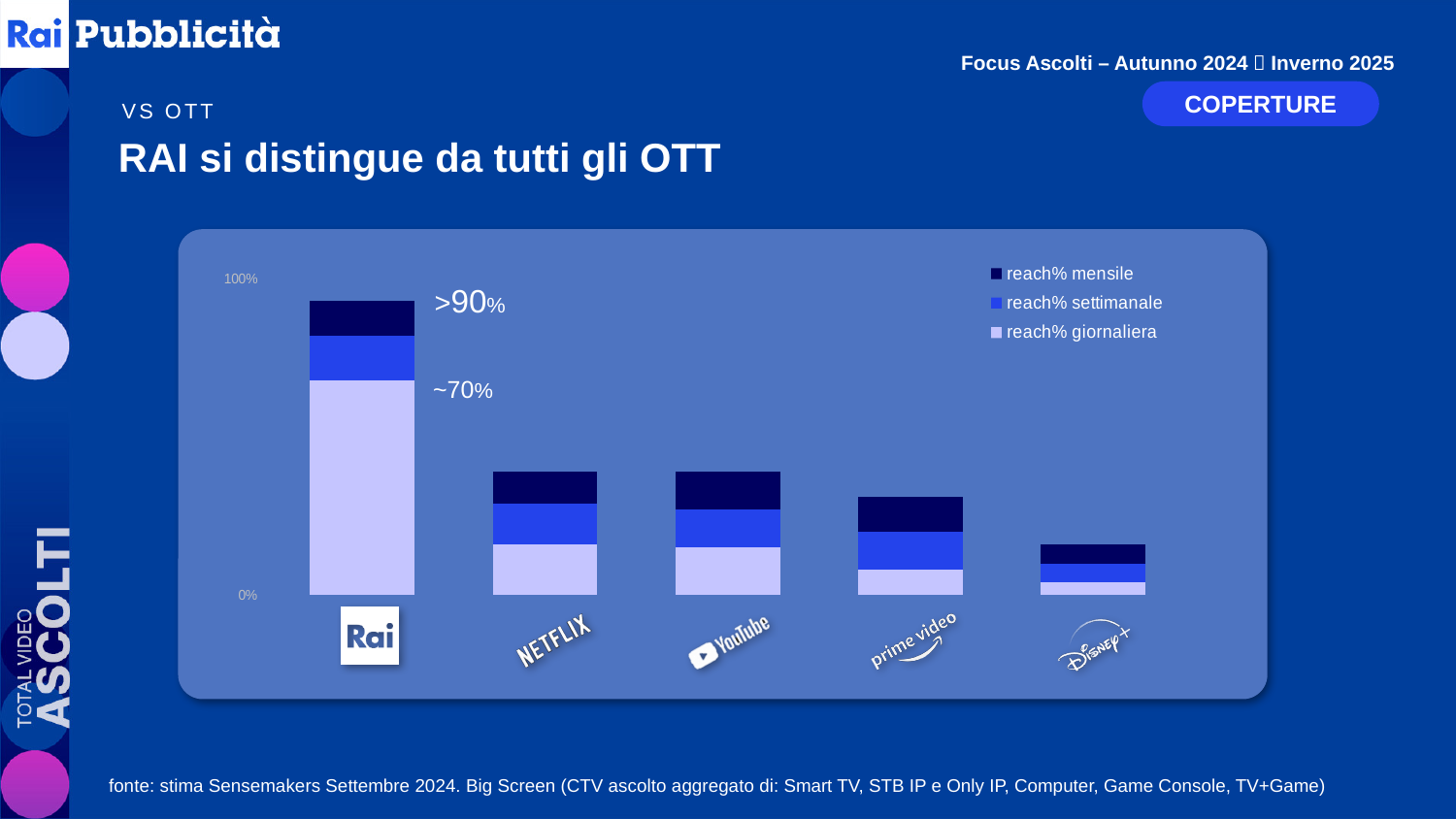
Is the total stacked value for Rai greater or less than 100%? less Which has the taller stacked bar, Rai or Netflix? Rai Which has the taller stacked bar, Netflix or Disney+? Netflix Which platform has the tallest stacked bar in the chart? Rai Which has the taller stacked bar, Prime Video or Disney+? Prime Video Do the stacked bar heights rise or fall moving from left to right across the platforms? Fall Which series is shown in the darkest colour at the top of each stacked bar? reach% mensile What kind of chart is shown on the slide? Stacked bar chart How many platforms (categories) are shown in the chart? 5 What is the title of the slide containing the chart? RAI si distingue da tutti gli OTT How many series does the chart legend list? 3 Which platform has the shortest stacked bar in the chart? Disney+